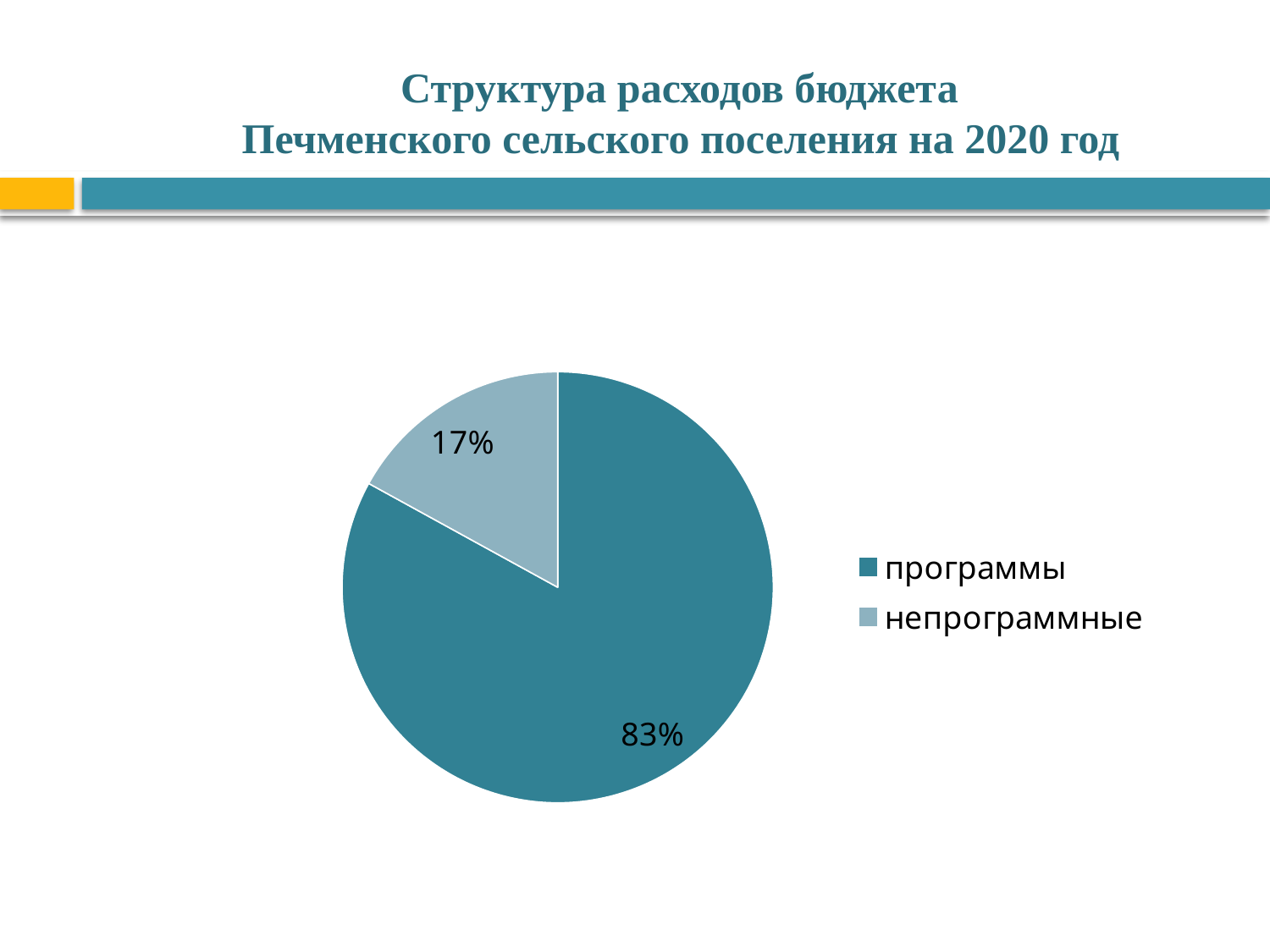
Which is larger, the "программы" slice or the "непрограммные" slice? программы How many slices does the pie chart have? 2 Which slice of the pie is the smallest? непрограммные What is the difference in percentage points between the "программы" and "непрограммные" slices? 66 How many entries does the legend list? 2 What kind of chart is shown on the slide? pie chart What share of the pie does the "непрограммные" slice represent? 17% Which legend entry is shown in the lighter blue colour? непрограммные What is the title of the slide? Структура расходов бюджета Печменского сельского поселения на 2020 год What share of the pie does the "программы" slice represent? 83% Which slice of the pie is the largest? программы